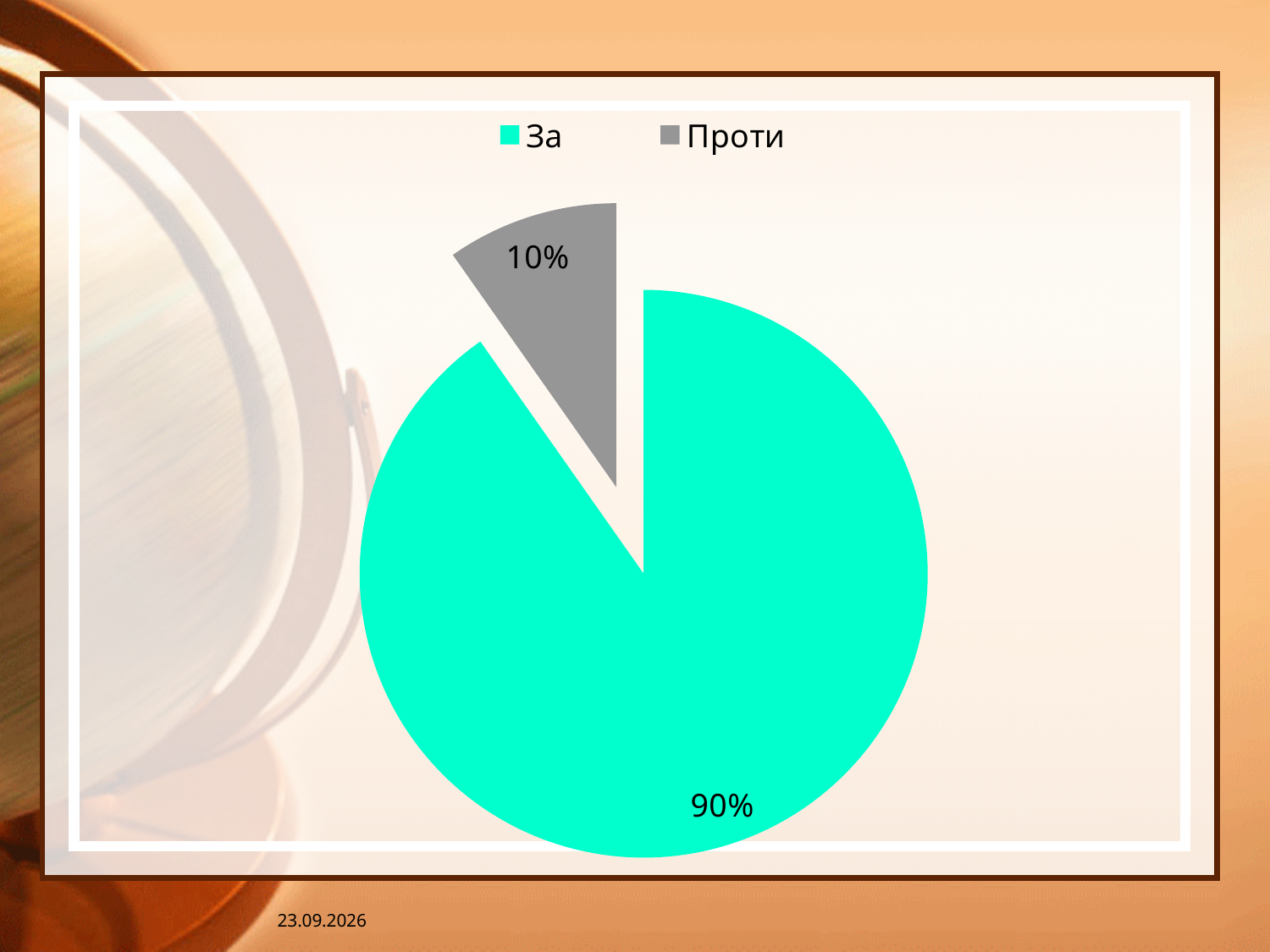
Which category is shown in the turquoise (green) colour? За What share of the pie does "За" represent? 90% Which is larger, the slice for "За" or the slice for "Проти"? За What share of the pie does "Проти" represent? 10% Which category has the largest slice of the pie? За What colour is the slice for "Проти"? grey What is the difference in percentage points between "За" and "Проти"? 80 What kind of chart is shown on the slide? pie chart How many slices does the pie chart have? 2 Which category has the smallest slice of the pie? Проти How many entries does the legend list? 2